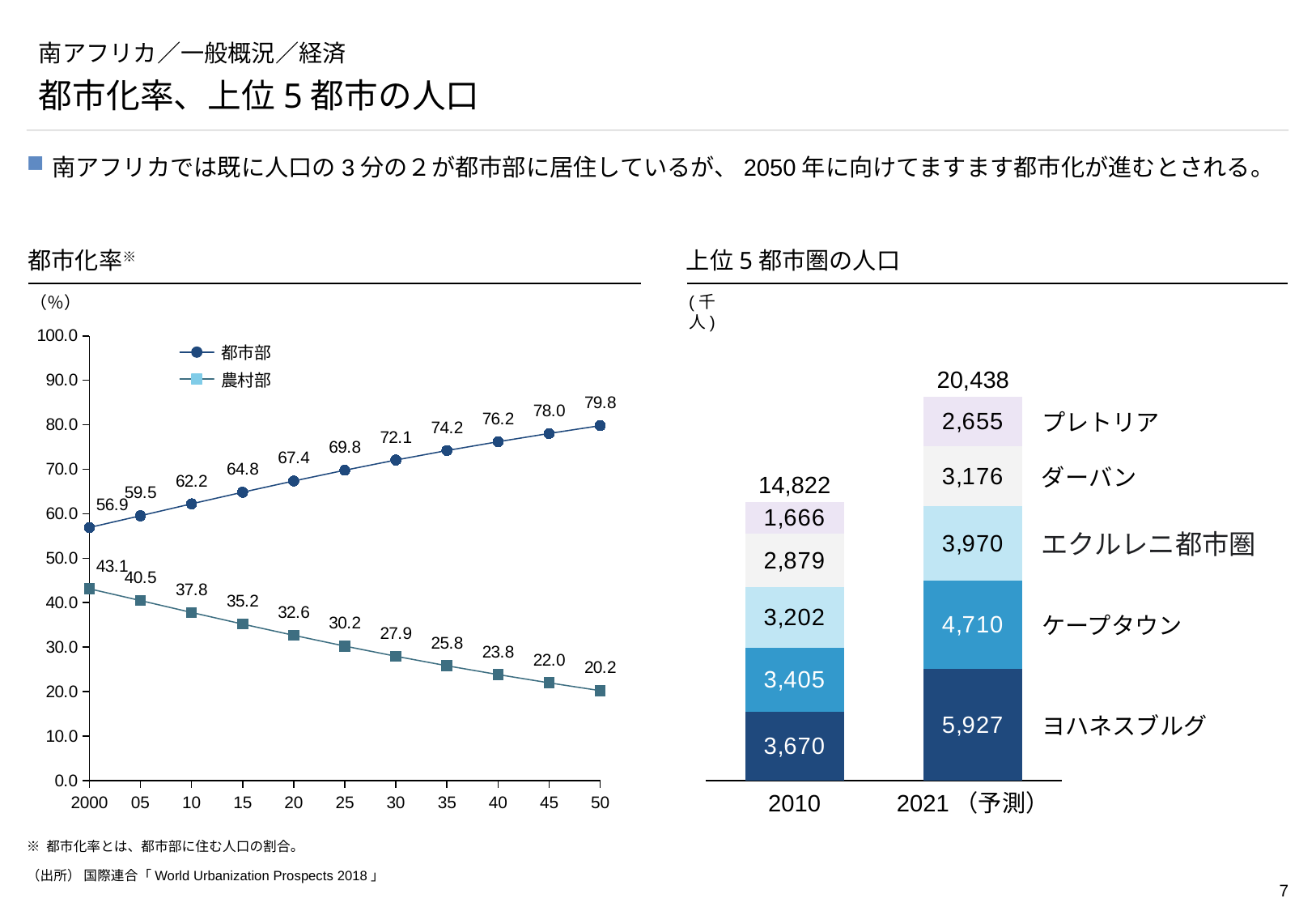
In the 都市化率 chart, how many series does the legend list? 2 In the 上位5都市圏の人口 chart, which city has the smallest value in 2010? プレトリア In the 都市化率 chart, how many data points does each series have? 11 In the 都市化率 chart, what is the value for 農村部 in 50? 20.2 In the 都市化率 chart, what is the value for 都市部 in 25? 69.8 What kind of chart is the 上位5都市圏の人口 chart? stacked bar chart In the 都市化率 chart, what is the value for 都市部 in 2000? 56.9 In the 都市化率 chart, does the 農村部 series rise or fall from 2000 to 50? fall In the 上位5都市圏の人口 chart, what is the value for ヨハネスブルグ in 2021 (予測)? 5,927 In the 上位5都市圏の人口 chart, what is the difference between ケープタウン in 2021 (予測) and in 2010? 1,305 In the 都市化率 chart, what is the difference between 都市部 and 農村部 in 50? 59.6 In the 上位5都市圏の人口 chart, what is the total of the 2010 bar? 14,822